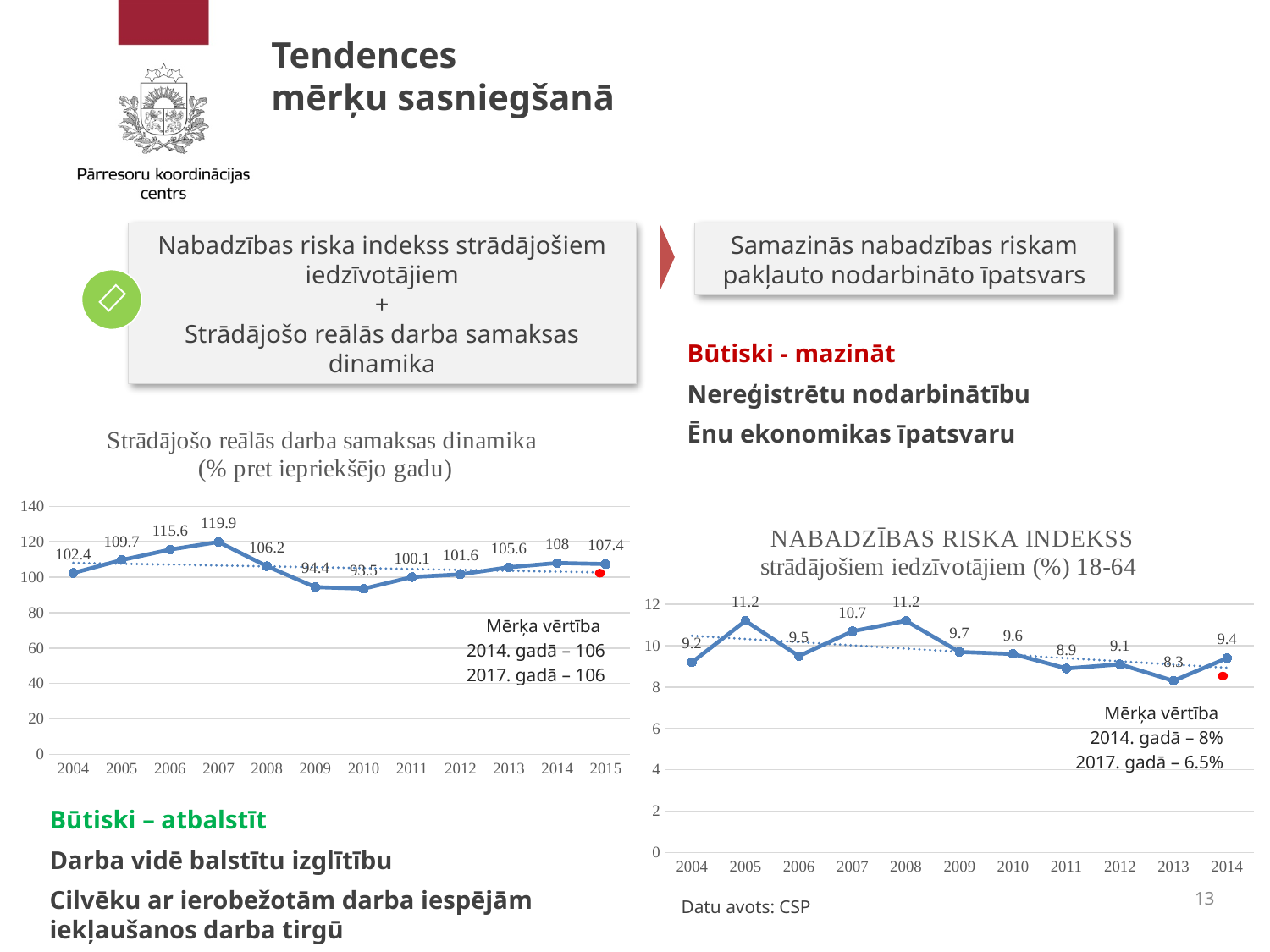
In the chart 'Strādājošo reālās darba samaksas dinamika', how many years are plotted on the x axis? 12 In the chart 'Nabadzības riska indekss', which year has the lowest value? 2013 In the chart 'Strādājošo reālās darba samaksas dinamika', which year has the lowest value? 2010 In the chart 'Strādājošo reālās darba samaksas dinamika', what is the difference between the values for 2007 and 2008? 13.7 In the chart 'Nabadzības riska indekss', what is the difference between the values for 2005 and 2004? 2 What type of chart is 'Strādājošo reālās darba samaksas dinamika'? Line chart In the chart 'Strādājošo reālās darba samaksas dinamika', what is the value for 2015? 107.4 In the chart 'Nabadzības riska indekss', which is larger, the value for 2007 or the value for 2009? 2007 In the chart 'Strādājošo reālās darba samaksas dinamika', which year has the highest value? 2007 In the chart 'Nabadzības riska indekss', what is the value for 2013? 8.3 In the chart 'Strādājošo reālās darba samaksas dinamika', what is the value for 2007? 119.9 In the chart 'Nabadzības riska indekss', what is the value for 2014? 9.4